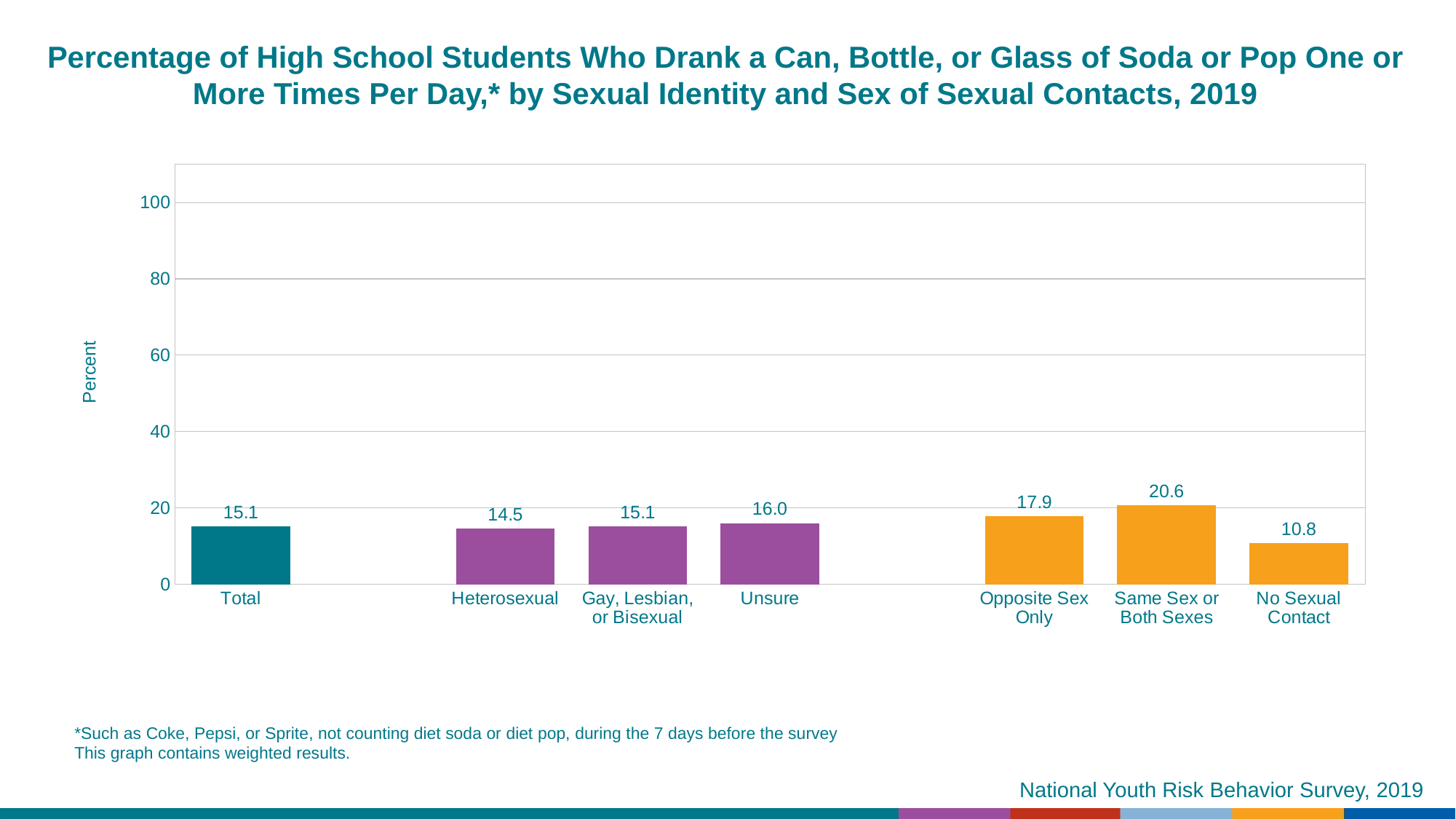
Which category has the highest value? Same Sex or Both Sexes What is the value for Heterosexual? 14.5 What is the value for No Sexual Contact? 10.8 What is the label of the y axis? Percent What is the value for Same Sex or Both Sexes? 20.6 Which is larger, the value for Unsure or the value for Heterosexual? Unsure Which category has the lowest value? No Sexual Contact Is the value for Opposite Sex Only greater or less than 20? less What is the value for Total? 15.1 What kind of chart is this? bar chart What is the difference between the values for Same Sex or Both Sexes and No Sexual Contact? 9.8 How many categories are shown on the chart? 7